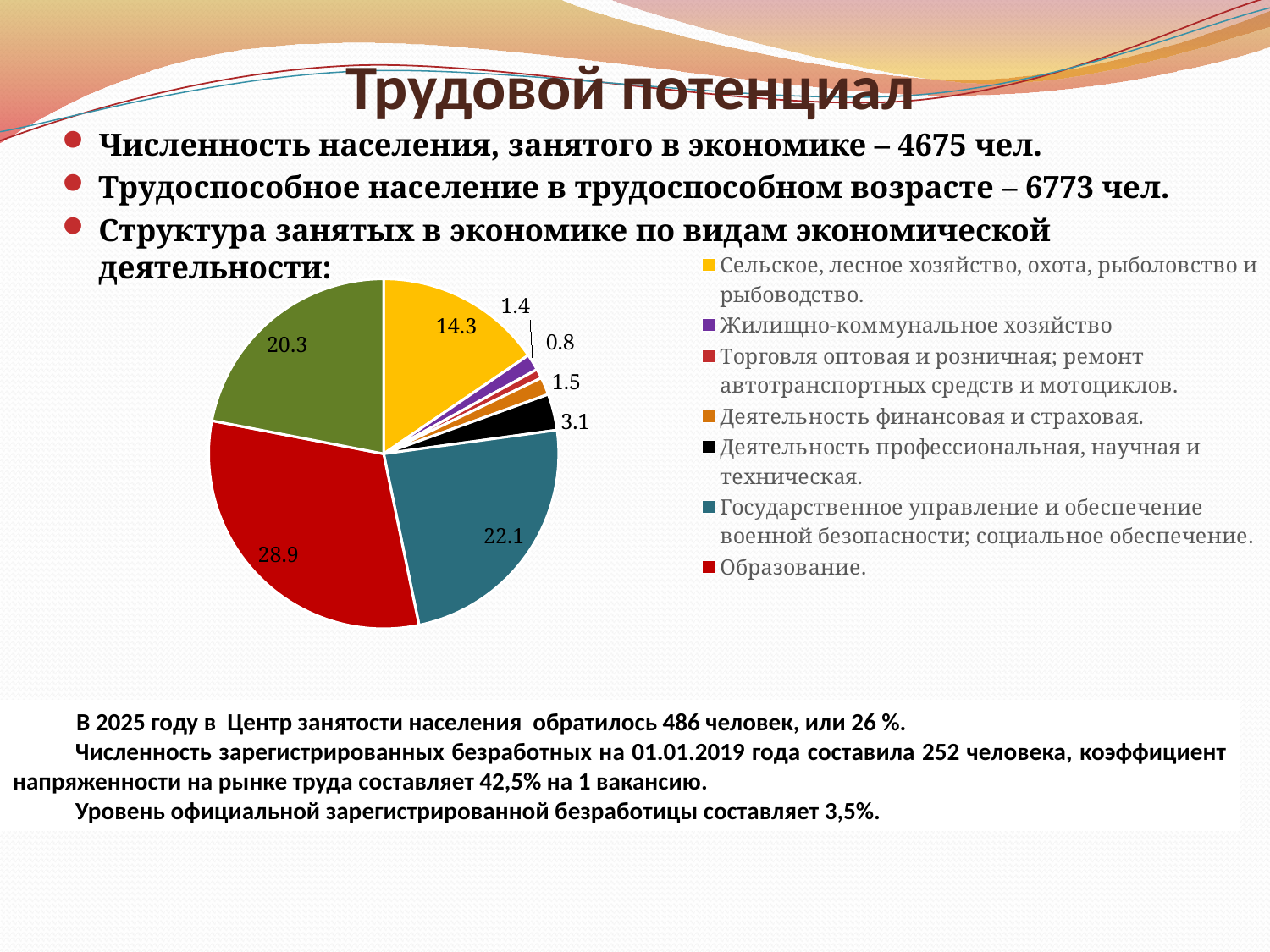
What is the difference between the values for "Образование" and "Государственное управление и обеспечение военной безопасности; социальное обеспечение"? 6.8 How many entries does the legend list? 7 What value is shown for the slice "Образование"? 28.9 What value is shown for the slice "Жилищно-коммунальное хозяйство"? 1.4 What value is shown for the slice "Сельское, лесное хозяйство, охота, рыболовство и рыбоводство"? 14.3 Which is larger: the slice for "Деятельность финансовая и страховая" or the slice for "Деятельность профессиональная, научная и техническая"? Деятельность профессиональная, научная и техническая What kind of chart is shown on the slide? pie chart How many slices does the pie chart have? 8 What value is shown for the slice "Деятельность профессиональная, научная и техническая"? 3.1 What value is shown for the slice "Государственное управление и обеспечение военной безопасности; социальное обеспечение"? 22.1 Which category has the largest slice of the pie? Образование Which category has the smallest slice of the pie? Торговля оптовая и розничная; ремонт автотранспортных средств и мотоциклов